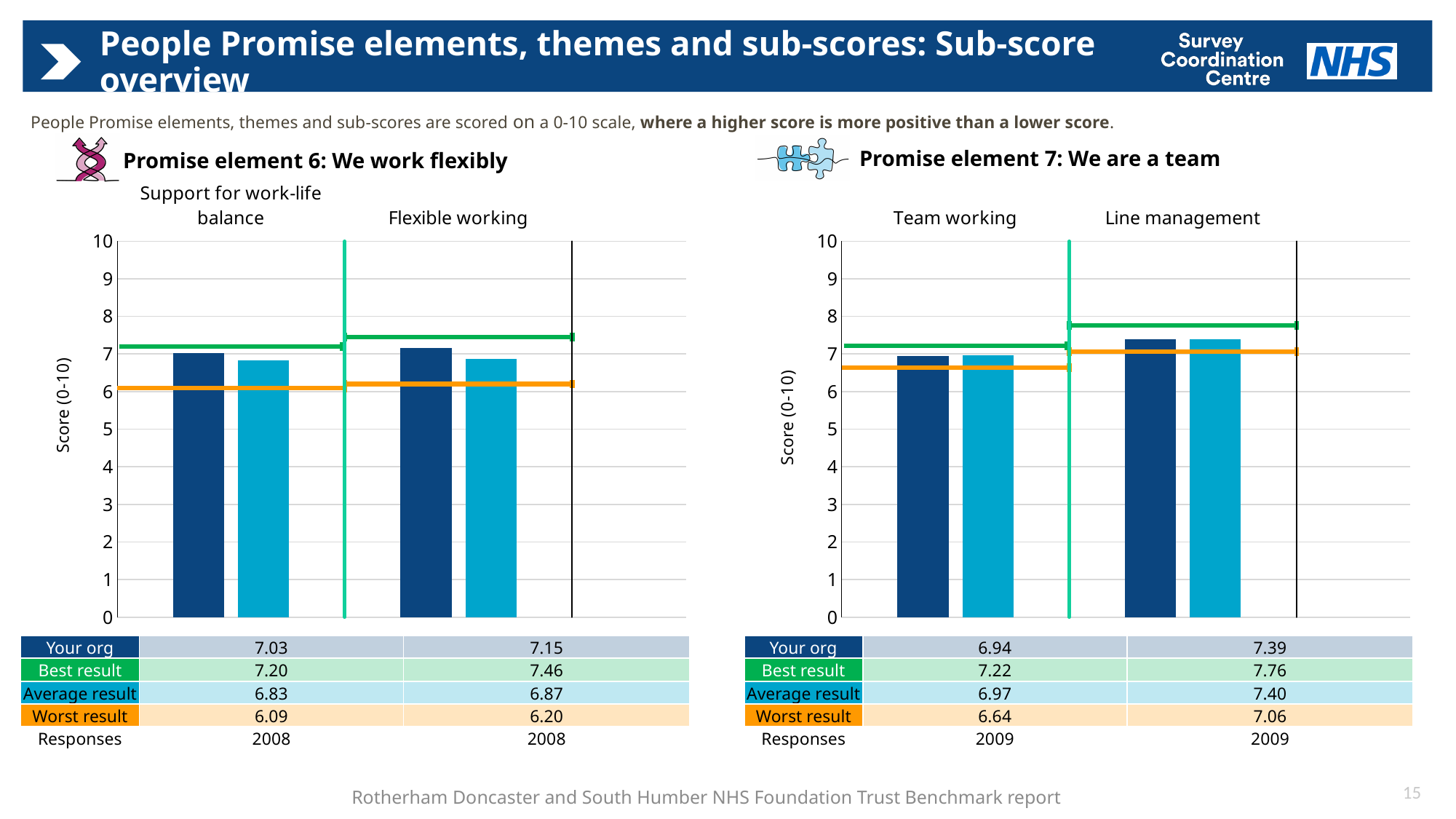
In the 'Promise element 7: We are a team' chart, what is the Average result for Line management? 7.40 In the 'Promise element 6: We work flexibly' chart, is the 'Your org' score for Flexible working greater or less than 7? greater What type of chart is used for 'Promise element 7: We are a team'? Bar chart In the 'Promise element 7: We are a team' chart, what is the Worst result for Team working? 6.64 In the 'Promise element 7: We are a team' chart, how many responses are shown for Line management? 2009 In the 'Promise element 6: We work flexibly' chart, what is the difference between the 'Your org' score and the Average result for Support for work-life balance? 0.20 How many sub-scores are plotted in the 'Promise element 6: We work flexibly' chart? 2 In the 'Promise element 6: We work flexibly' chart, what is the Best result for Flexible working? 7.46 In the 'Promise element 7: We are a team' chart, is the 'Your org' score for Team working greater or less than 7? less In the 'Promise element 7: We are a team' chart, which sub-score has the higher 'Your org' value, Team working or Line management? Line management In the 'Promise element 6: We work flexibly' chart, what is the 'Your org' score for Support for work-life balance? 7.03 In the 'Promise element 7: We are a team' chart, what is the difference between the Best result and the Worst result for Line management? 0.70